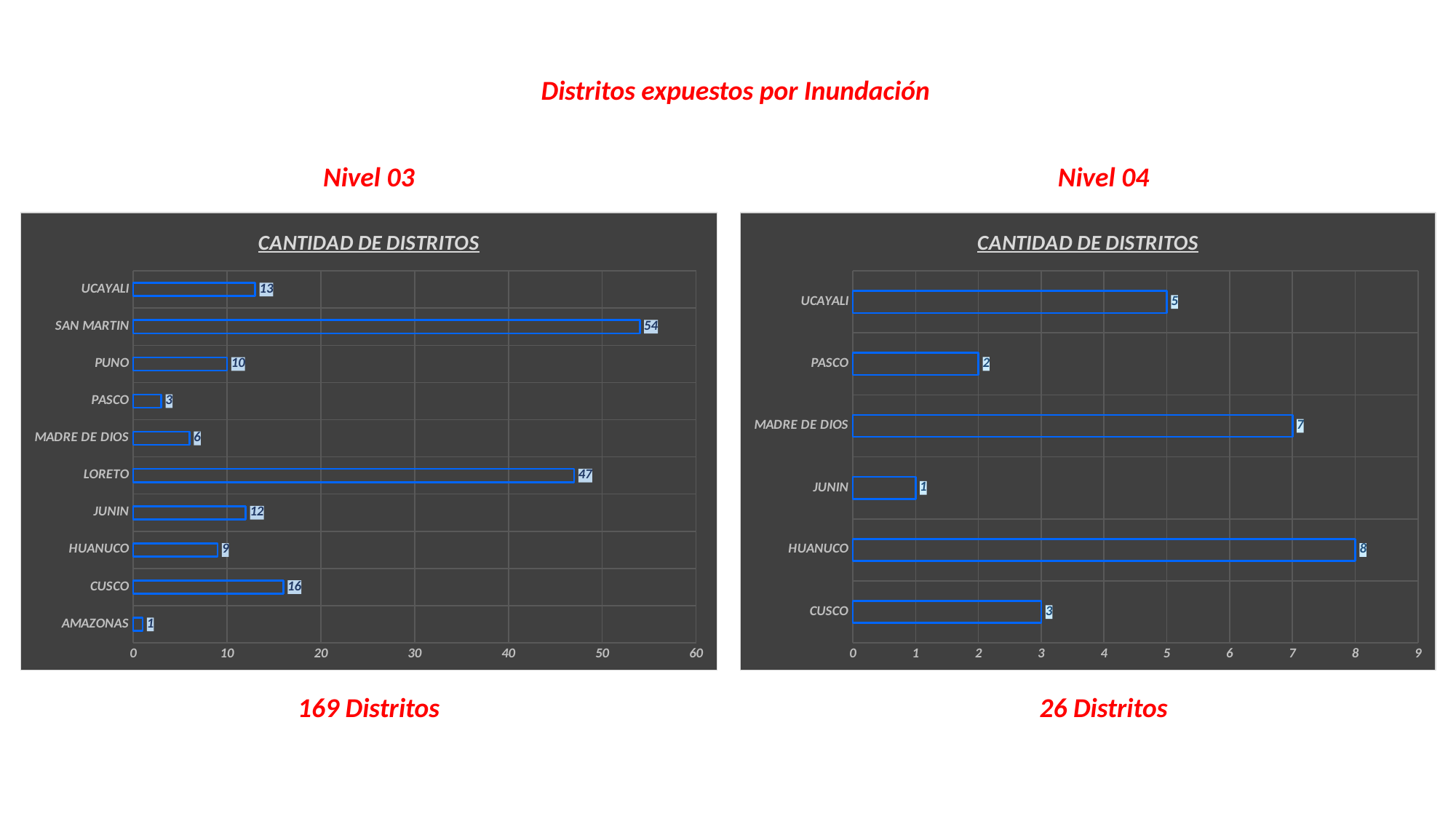
In the Nivel 03 chart, what is the value for SAN MARTIN? 54 In the Nivel 03 chart, how many categories are shown? 10 In the Nivel 03 chart, what is the difference between the values for SAN MARTIN and LORETO? 7 In the Nivel 04 chart, how many categories are shown? 6 In the Nivel 04 chart, which category has the highest value? HUANUCO In the Nivel 04 chart, which is larger, the value for UCAYALI or the value for CUSCO? UCAYALI In the Nivel 04 chart, which category has the lowest value? JUNIN In the Nivel 04 chart, what is the value for MADRE DE DIOS? 7 In the Nivel 03 chart, what is the value for LORETO? 47 What kind of chart is the Nivel 04 chart? Bar chart In the Nivel 03 chart, which category has the highest value? SAN MARTIN In the Nivel 03 chart, which category has the lowest value? AMAZONAS